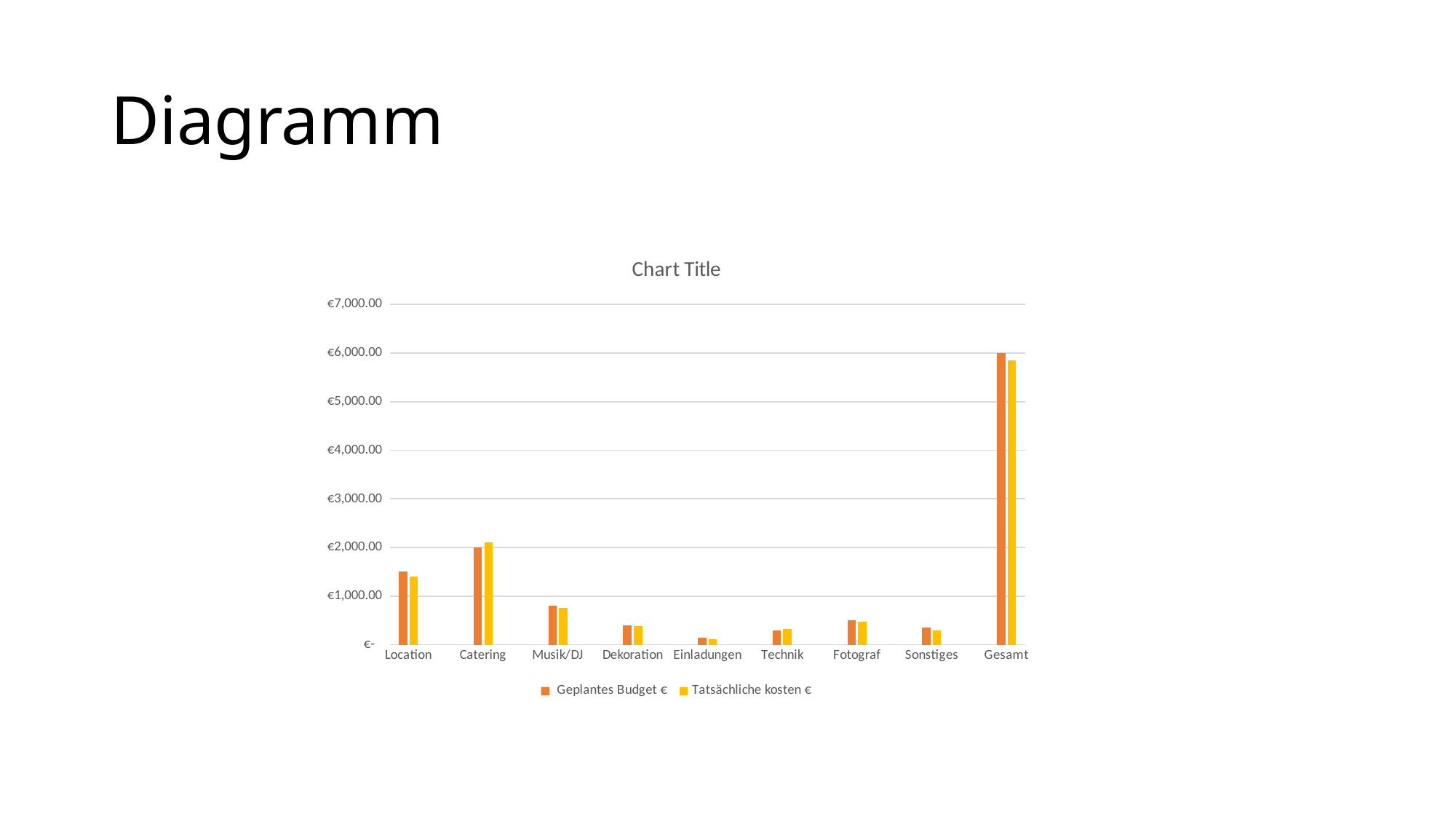
What is the Geplantes Budget € value for Catering? €2,000.00 What kind of chart is shown on the slide? bar chart For Catering, which is larger: Geplantes Budget € or Tatsächliche kosten €? Tatsächliche kosten € What is the Geplantes Budget € value for Gesamt? €6,000.00 How many categories are shown on the x axis? 9 Which category has the highest Geplantes Budget € value? Gesamt Which category has the lowest Tatsächliche kosten € value? Einladungen For Location, which is larger: Geplantes Budget € or Tatsächliche kosten €? Geplantes Budget € Is the Geplantes Budget € value for Location greater or less than €1,000.00? greater Is the Tatsächliche kosten € value for Musik/DJ greater or less than €1,000.00? less What is the title of the chart? Chart Title How many series does the legend list? 2